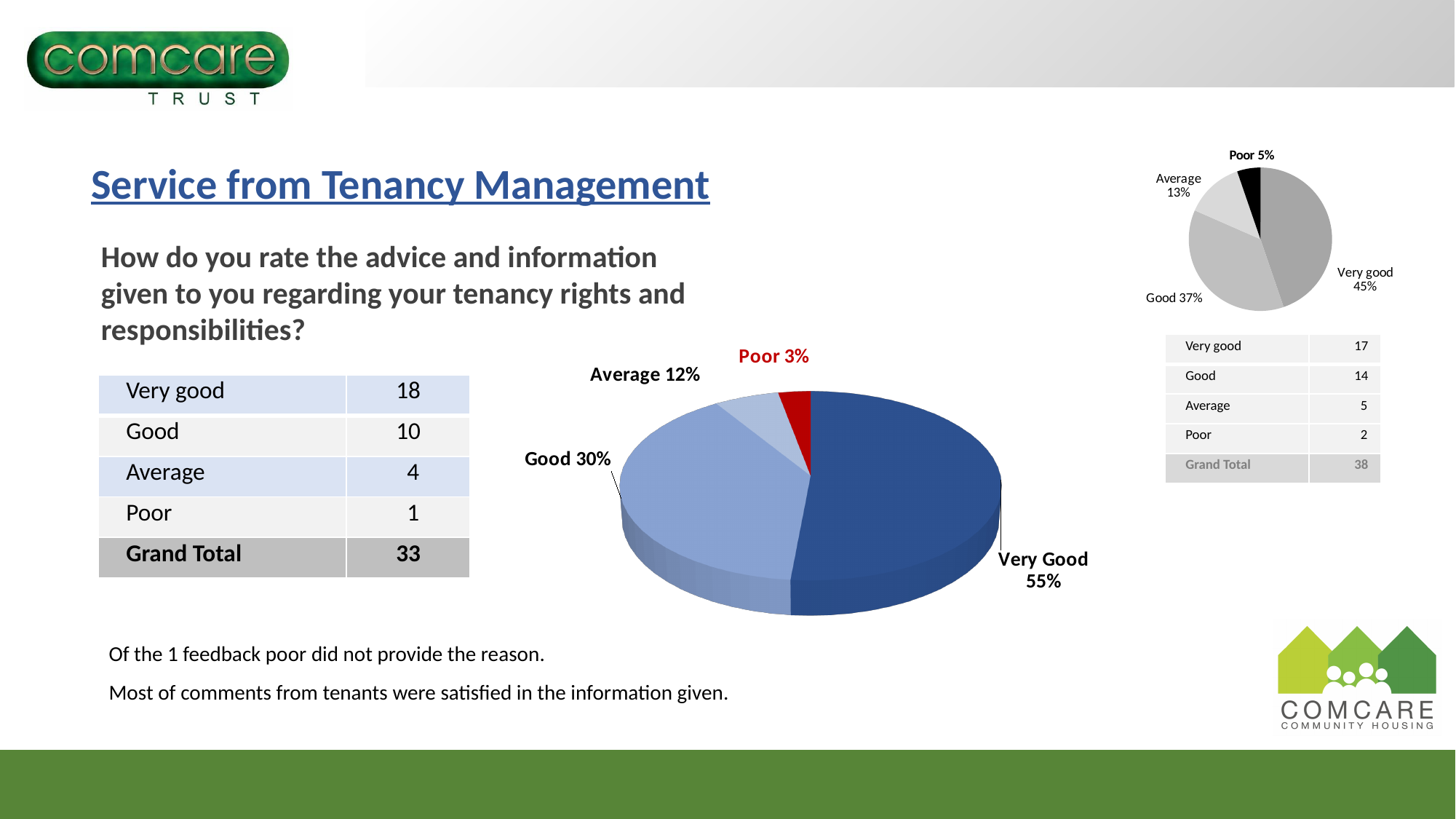
On the large pie chart in the centre of the slide, what share is labelled for Average? 12% On the large pie chart in the centre of the slide, which category has the smallest slice? Poor On the small pie chart in the top right of the slide, what share is labelled for Good? 37% On the large pie chart in the centre of the slide, what share is labelled for Good? 30% On the large pie chart in the centre of the slide, how many slices are there? 4 On the small pie chart in the top right of the slide, which category has the smallest slice? Poor On the large pie chart in the centre of the slide, what share is labelled for Poor? 3% On the large pie chart in the centre of the slide, what share is labelled for Very Good? 55% What kind of chart is the large chart in the centre of the slide? Pie chart On the large pie chart in the centre of the slide, which category has the largest slice? Very Good On the small pie chart in the top right of the slide, what is the difference in percentage points between the Very good and Good slices? 8 On the small pie chart in the top right of the slide, what share is labelled for Very good? 45%